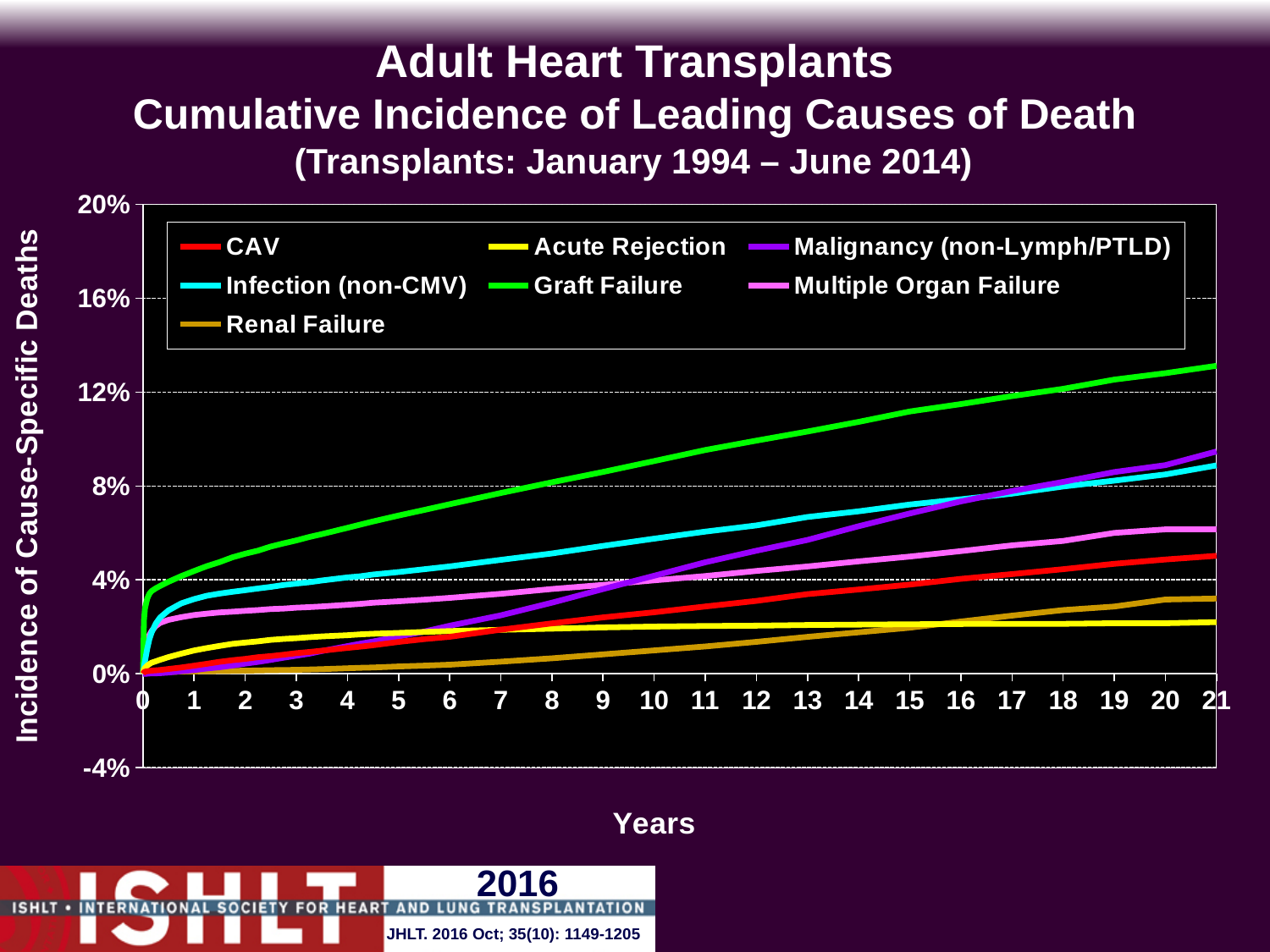
Is the value for Acute Rejection at year 21 greater or less than 4%? less Is the value for Graft Failure at year 21 greater or less than 12%? greater Is the value for Multiple Organ Failure at year 21 greater or less than 8%? less Which cause of death has the lowest cumulative incidence at year 21? Acute Rejection Does the Graft Failure line rise or fall as years increase? rise How many series does the legend list? 7 What is the label of the y axis? Incidence of Cause-Specific Deaths Which cause of death has the highest cumulative incidence at year 21? Graft Failure At year 10, which is larger: the value for Graft Failure or the value for Infection (non-CMV)? Graft Failure At year 2, which is larger: the value for Acute Rejection or the value for Malignancy (non-Lymph/PTLD)? Acute Rejection What kind of chart is shown on the slide? line chart